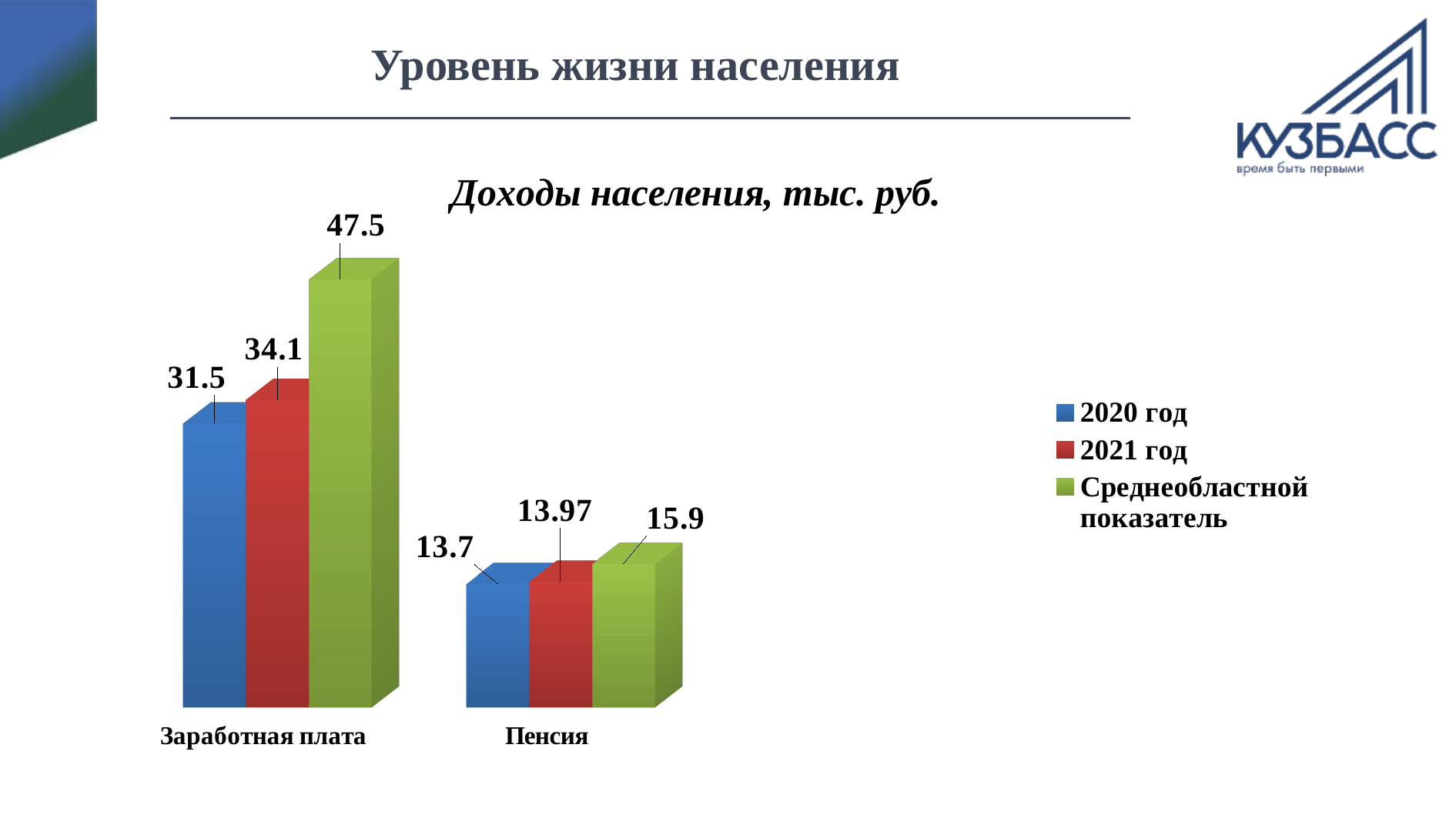
What is the value for Заработная плата in the 2020 год series? 31.5 Which is larger: the 2020 год value for Заработная плата or the 2020 год value for Пенсия? Заработная плата How many series does the legend list? 3 How many categories are shown on the x axis? 2 What is the value for Заработная плата in the 2021 год series? 34.1 Which series has the lowest value for Пенсия? 2020 год What is the difference between the Среднеобластной показатель and the 2021 год value for Заработная плата? 13.4 Which series has the highest value for Заработная плата? Среднеобластной показатель What is the Среднеобластной показатель value for Заработная плата? 47.5 What is the value for Пенсия in the 2021 год series? 13.97 What is the Среднеобластной показатель value for Пенсия? 15.9 What kind of chart is shown on the slide? Bar chart